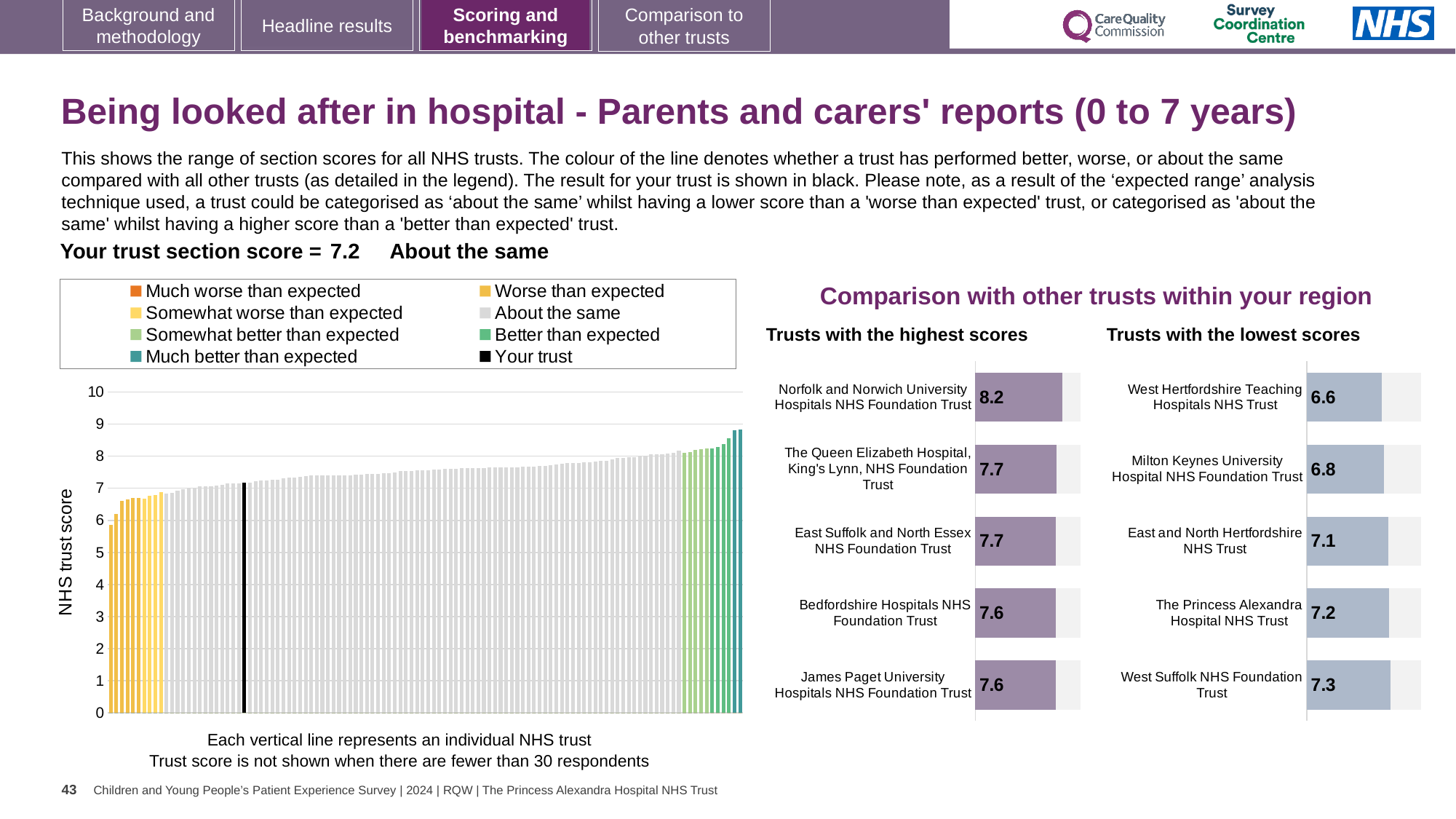
In the 'Trusts with the lowest scores' chart, which has the larger score: Milton Keynes University Hospital NHS Foundation Trust or East and North Hertfordshire NHS Trust? East and North Hertfordshire NHS Trust In the 'Trusts with the highest scores' chart, what is the score for Norfolk and Norwich University Hospitals NHS Foundation Trust? 8.2 In the 'Trusts with the lowest scores' chart, which trust has the lowest score? West Hertfordshire Teaching Hospitals NHS Trust In the 'Trusts with the highest scores' chart, which trust has the highest score? Norfolk and Norwich University Hospitals NHS Foundation Trust How many entries does the legend of the chart of all NHS trust scores list? 8 In the chart of all NHS trust scores, what is the section score for your trust (shown in black)? 7.2 In the 'Trusts with the highest scores' chart, what is the difference between the scores of Norfolk and Norwich University Hospitals NHS Foundation Trust and Bedfordshire Hospitals NHS Foundation Trust? 0.6 In the 'Trusts with the lowest scores' chart, what is the score for West Hertfordshire Teaching Hospitals NHS Trust? 6.6 In the 'Trusts with the lowest scores' chart, what is the difference between the scores of West Suffolk NHS Foundation Trust and West Hertfordshire Teaching Hospitals NHS Trust? 0.7 How many trusts are shown in the 'Trusts with the highest scores' chart? 5 In the chart of all NHS trust scores, is the highest trust score greater or less than 8? greater What kind of chart is the chart of all NHS trust scores on the left of the slide? bar chart